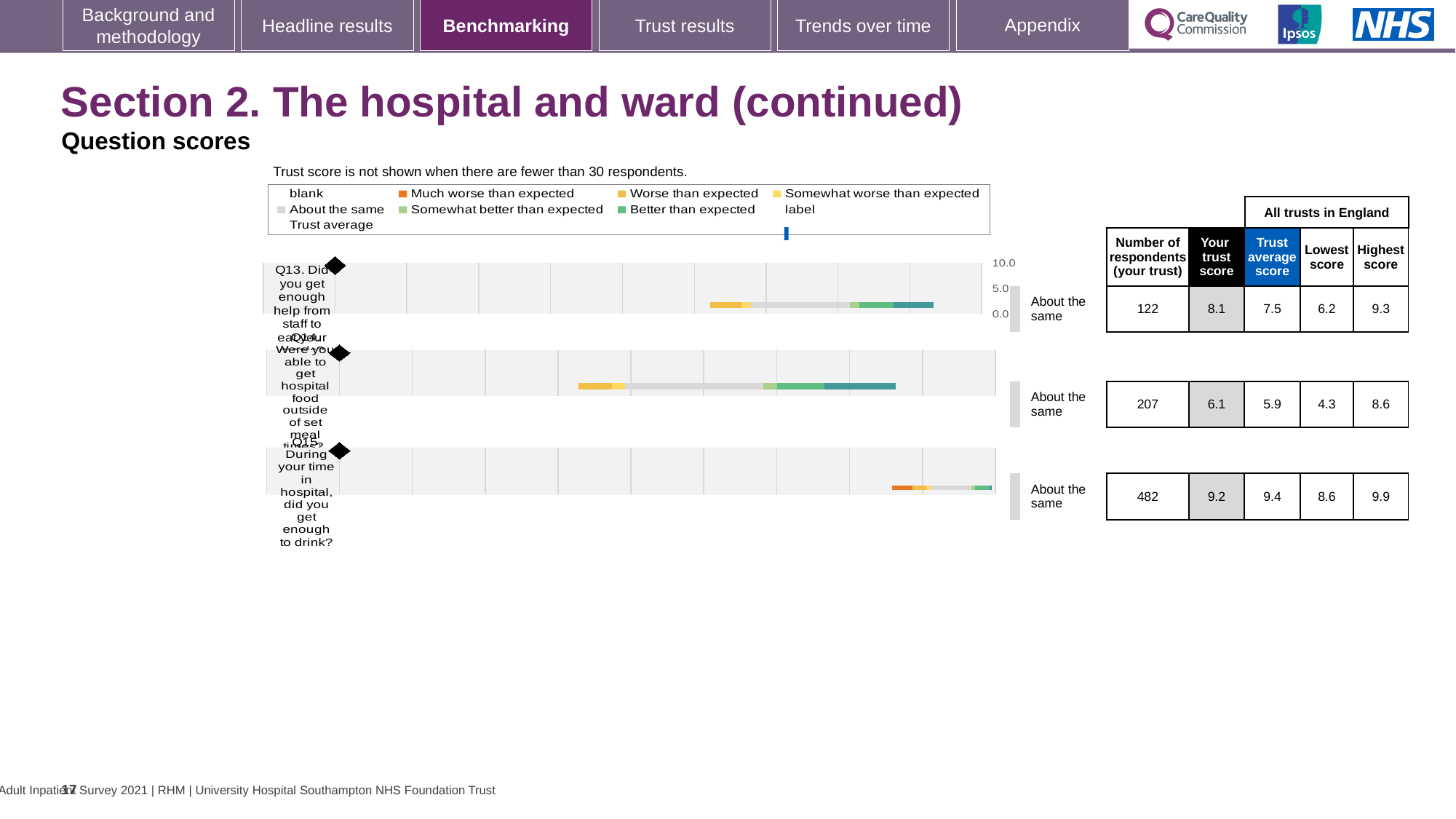
For Q13, what is the difference between the highest score (9.3) and the lowest score (6.2)? 3.1 How many questions (Q13, Q14, Q15) are plotted as bars on this slide? 3 For the Q14 bar (hospital food outside of set meal times), what is the trust average score? 5.9 Which of the three questions has the lowest 'Your trust score'? Q14 What kind of chart is used to show the question scores on this slide? bar chart For the Q15 bar (enough to drink), what is the highest score among all trusts in England? 9.9 Which of the three questions has the highest 'Your trust score'? Q15 Which legend entry is shown in the darkest orange colour? Much worse than expected For Q13, which is larger: 'Your trust score' or the trust average score? Your trust score For the Q13 bar (help from staff to eat meals), what is the number of respondents shown? 122 What benchmark category is shown next to each of the three bars? About the same For the Q13 bar, what is 'Your trust score'? 8.1